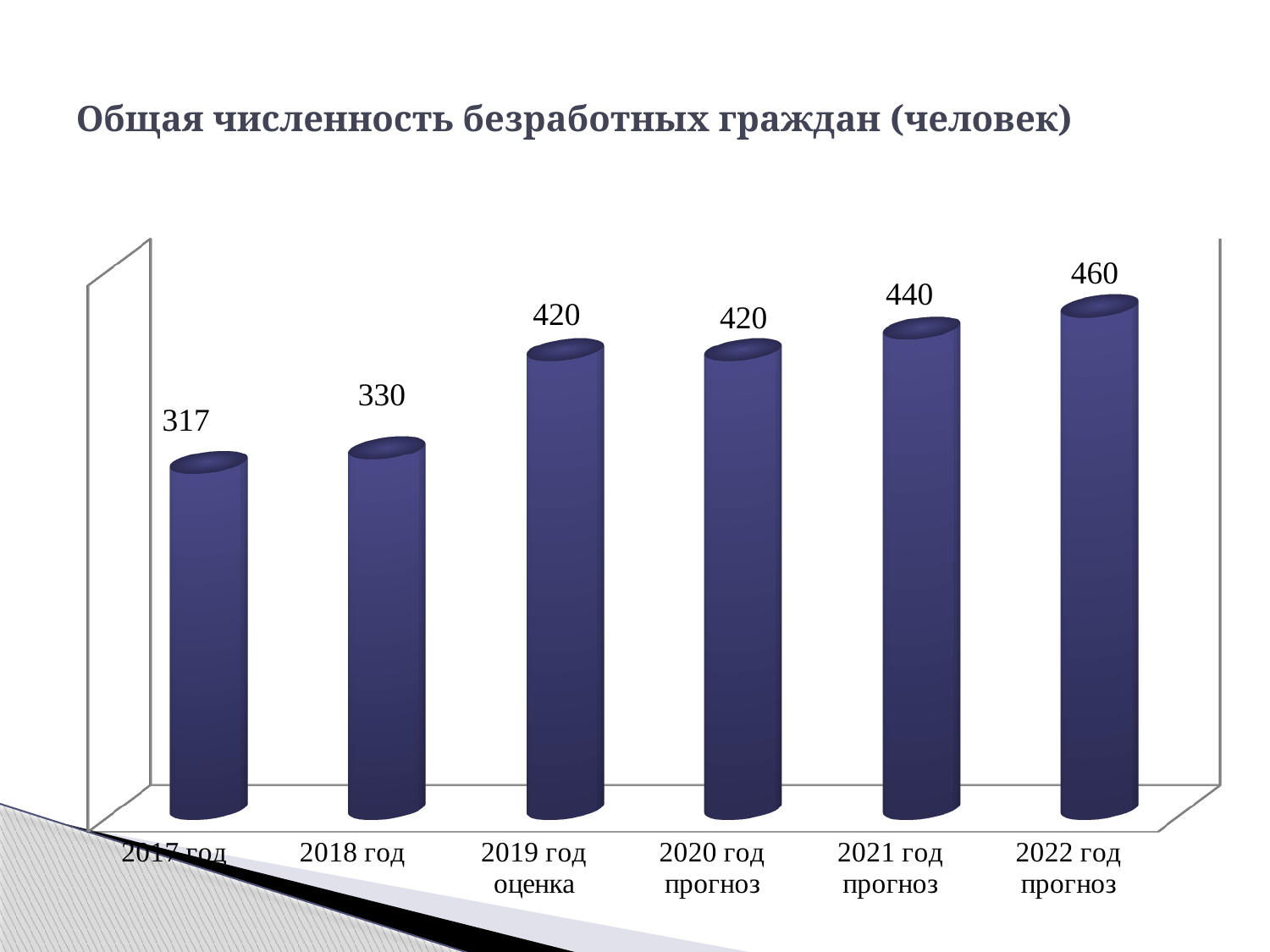
Which is larger, the value for 2021 год прогноз or the value for 2020 год прогноз? 2021 год прогноз What kind of chart is this? bar chart How many categories are shown on the x axis? 6 What is the value for 2018 год? 330 Which category has the lowest value? 2017 год What is the difference between the values for 2019 год оценка and 2018 год? 90 Do the values generally rise or fall from 2017 год to 2022 год прогноз? rise Which category has the highest value? 2022 год прогноз What is the title of the chart? Общая численность безработных граждан (человек) What is the value for 2021 год прогноз? 440 What is the value for 2017 год? 317 What is the difference between the values for 2022 год прогноз and 2017 год? 143